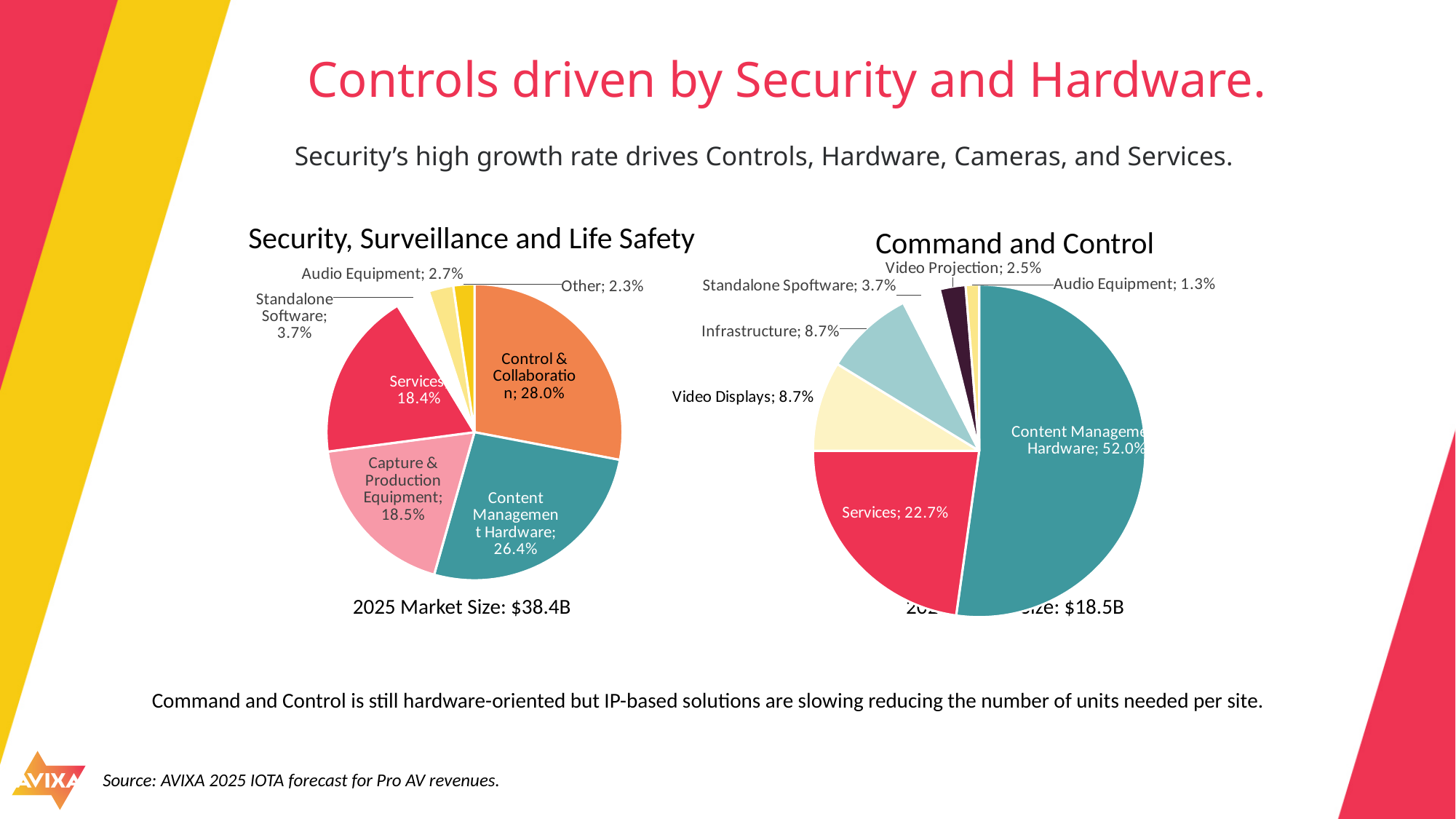
In the Command and Control chart, what share does Content Management Hardware hold? 52.0% In the Security, Surveillance and Life Safety chart, which category has the smallest share? Other In the Command and Control chart, what is the difference between the shares of Content Management Hardware and Services? 29.3% In the Security, Surveillance and Life Safety chart, which is larger: Content Management Hardware or Services? Content Management Hardware How many slices does the Command and Control pie chart have? 7 In the Security, Surveillance and Life Safety chart, what is the share for Audio Equipment? 2.7% In the Command and Control chart, which category has the smallest share? Audio Equipment What 2025 market size is shown under the Security, Surveillance and Life Safety chart? $38.4B In the Command and Control chart, what is the share for Services? 22.7% In the Security, Surveillance and Life Safety chart, which category has the largest share? Control & Collaboration In the Security, Surveillance and Life Safety chart, what share does Control & Collaboration hold? 28.0% What type of chart is used for Security, Surveillance and Life Safety? Pie chart